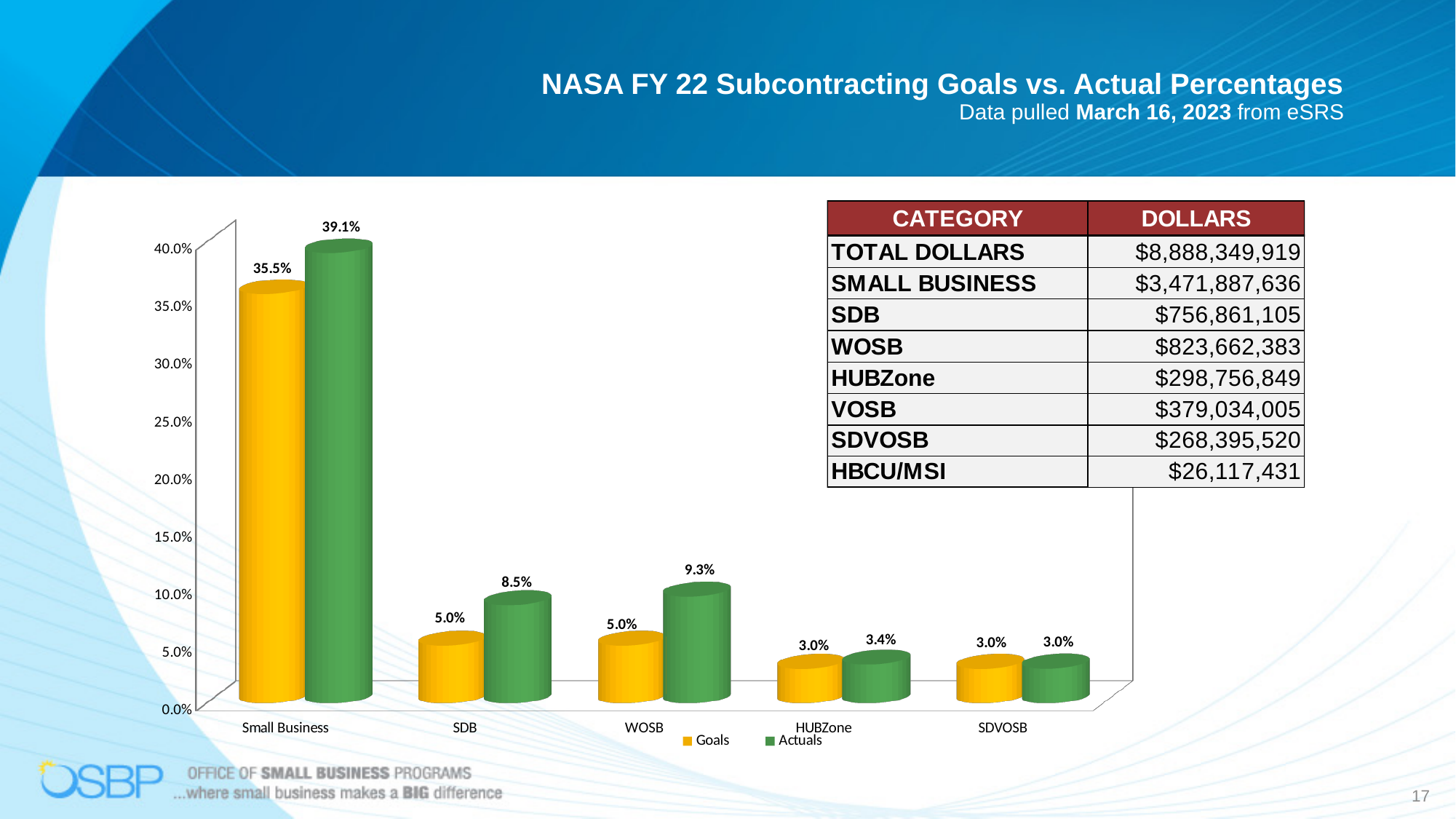
What kind of chart is shown on the slide? Bar chart What is the difference between the Actuals and Goals values for Small Business? 3.6% What is the Actuals value for Small Business? 39.1% Which category has the lowest Goals value? HUBZone and SDVOSB (both 3.0%) What is the Actuals value for HUBZone? 3.4% How many series does the chart legend list? 2 What is the Actuals value for WOSB? 9.3% Which is larger for WOSB, the Goals value or the Actuals value? Actuals What is the difference between the Actuals and Goals values for SDB? 3.5% How many categories are shown on the x axis of the chart? 5 What is the Goals value for SDB? 5.0% Which category has the highest Actuals value? Small Business